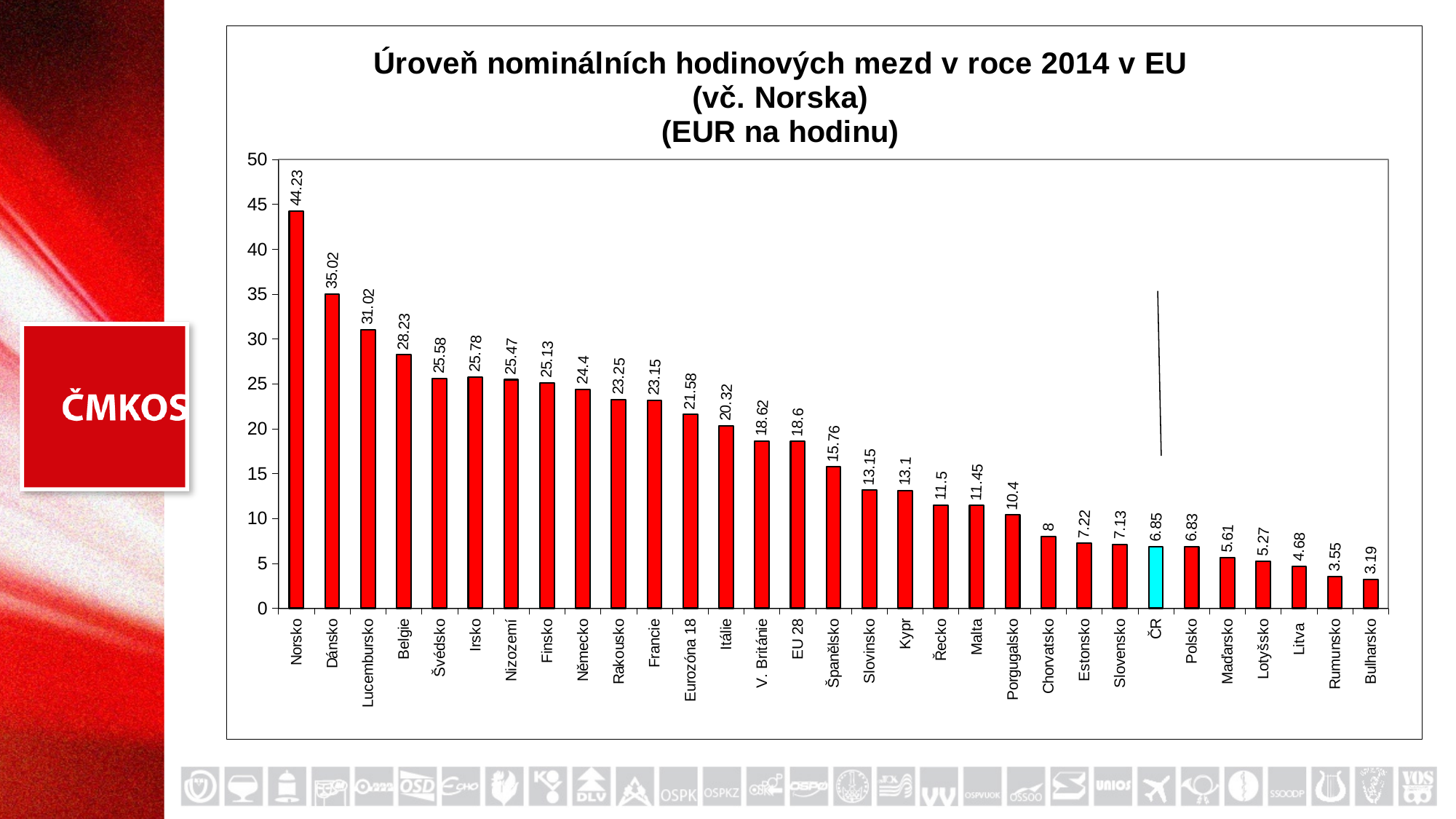
How many categories are shown on the x axis? 31 Which country has the highest hourly wage in the chart? Norsko What is the value for Norsko? 44.23 What is the value for EU 28? 18.6 What is the difference between the values for Norsko and Bulharsko? 41.04 What kind of chart is shown on the slide? bar chart Which bar is coloured differently (cyan) from the others? ČR What is the difference between the values for EU 28 and ČR? 11.75 Is the value for Dánsko greater or less than 30? greater Which country has the lowest hourly wage in the chart? Bulharsko What is the value for ČR? 6.85 Which is larger, the value for Německo or the value for Polsko? Německo